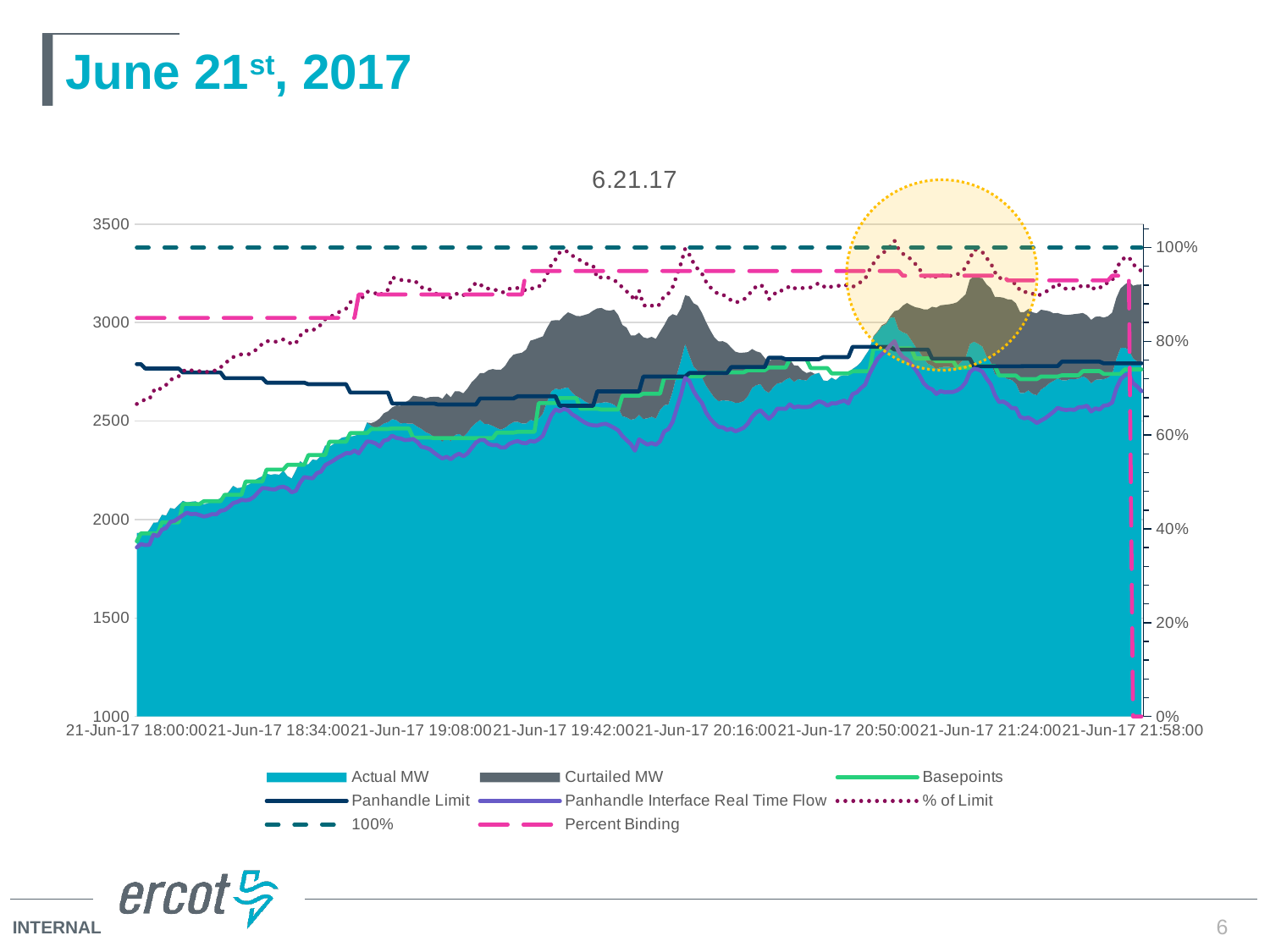
Does Actual MW rise or fall between 21-Jun-17 18:00:00 and 21-Jun-17 19:42:00? rise What is the title of the chart? 6.21.17 Which series is drawn as a dotted line in the chart? % of Limit Is the Panhandle Limit at 21-Jun-17 18:00:00 greater or less than 2500? greater Is the Actual MW value at 21-Jun-17 21:24:00 greater or less than 2500? greater Is the % of Limit value at 21-Jun-17 18:00:00 greater or less than 80%? less How many series does the chart legend list? 8 What kind of chart is shown on the slide? Area chart with line series At 21-Jun-17 19:42:00, which is higher: Basepoints or Panhandle Interface Real Time Flow? Basepoints